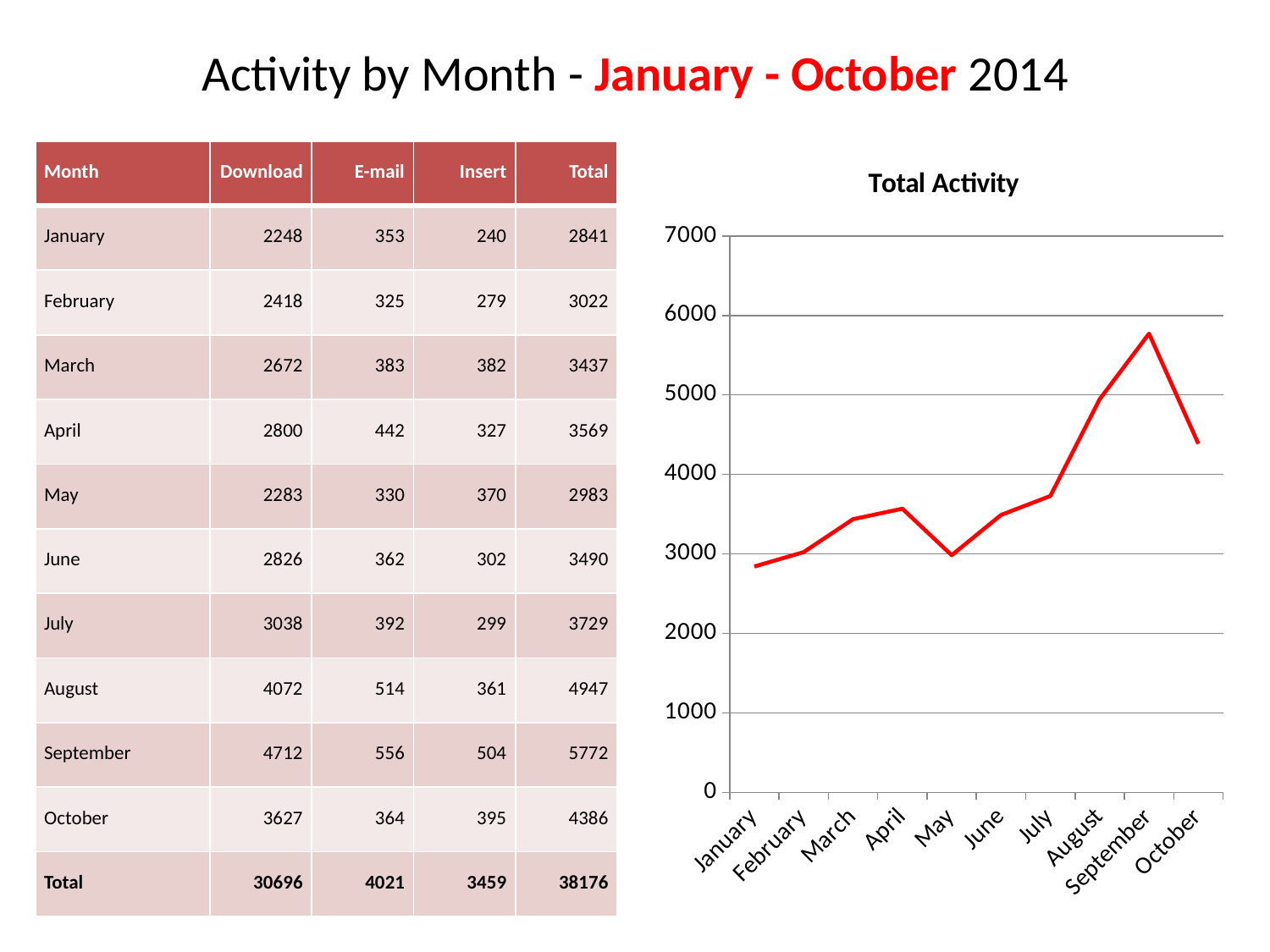
Is the value for September on the Total Activity chart greater or less than 5000? greater Is the value for October on the Total Activity chart greater or less than 4000? greater What is the title of the line chart? Total Activity Which month has the highest value on the Total Activity chart? September Is the value for July on the Total Activity chart greater or less than 4000? less What is the total activity value for September shown on the slide? 5772 On the Total Activity chart, does the line rise or fall from January to April? rise What kind of chart is the Total Activity chart? line chart How many months are plotted on the Total Activity chart? 10 On the Total Activity chart, does the line rise or fall from September to October? fall Which month has the lowest value on the Total Activity chart? January On the Total Activity chart, which is larger, the value for August or the value for October? August